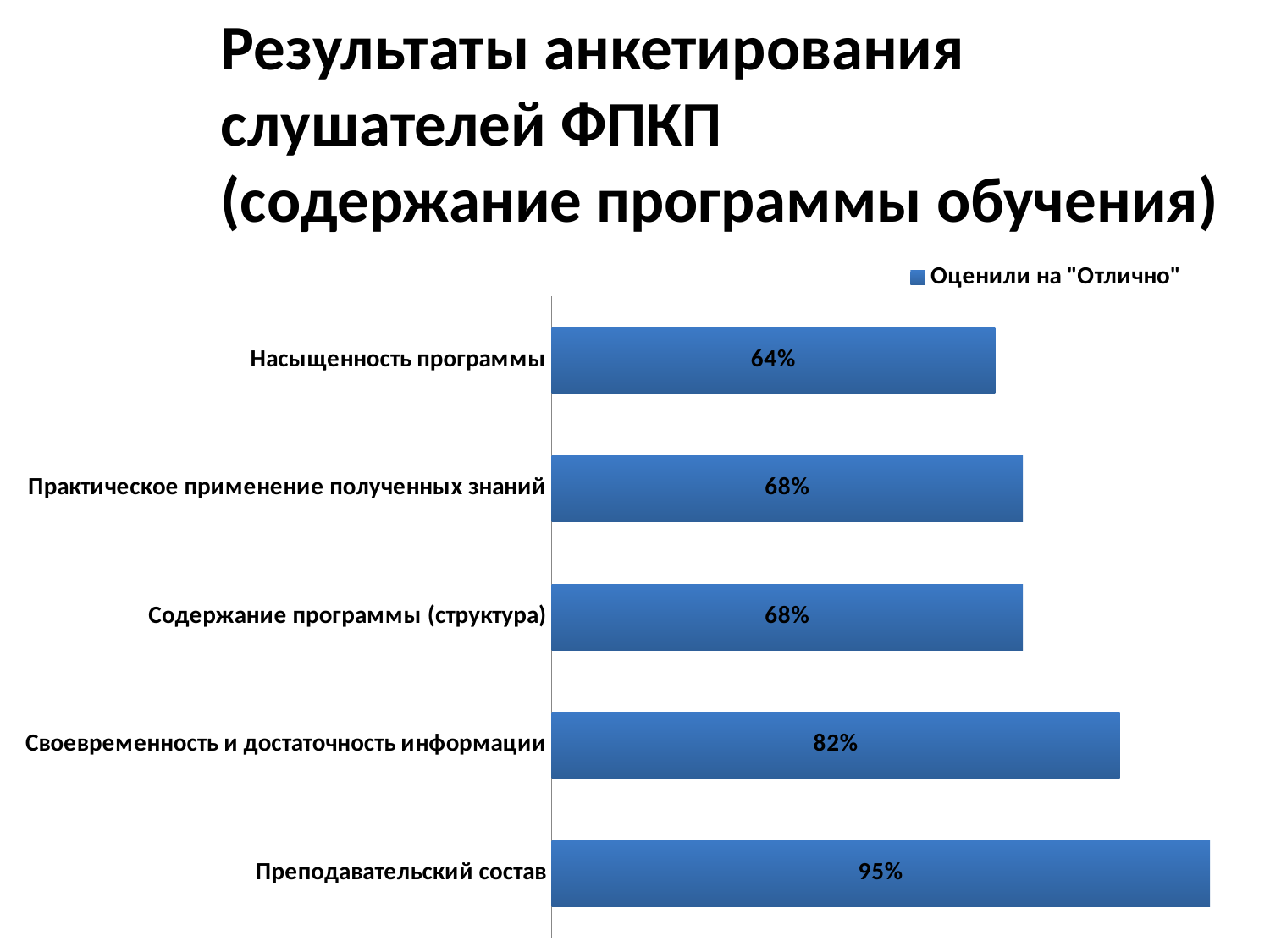
What is the value for "Своевременность и достаточность информации"? 82% How many categories are shown in the chart? 5 What is the difference between the values for "Преподавательский состав" and "Насыщенность программы"? 31% What is the legend entry of the series shown in the chart? Оценили на "Отлично" Which category has the highest value? Преподавательский состав What kind of chart is shown on the slide? Bar chart Which is larger: the value for "Своевременность и достаточность информации" or for "Практическое применение полученных знаний"? Своевременность и достаточность информации How many series does the legend list? 1 What percentage rated "Преподавательский состав" as "Отлично"? 95% Which category has the lowest value? Насыщенность программы What is the difference between the values for "Своевременность и достаточность информации" and "Содержание программы (структура)"? 14% What is the value for "Насыщенность программы"? 64%